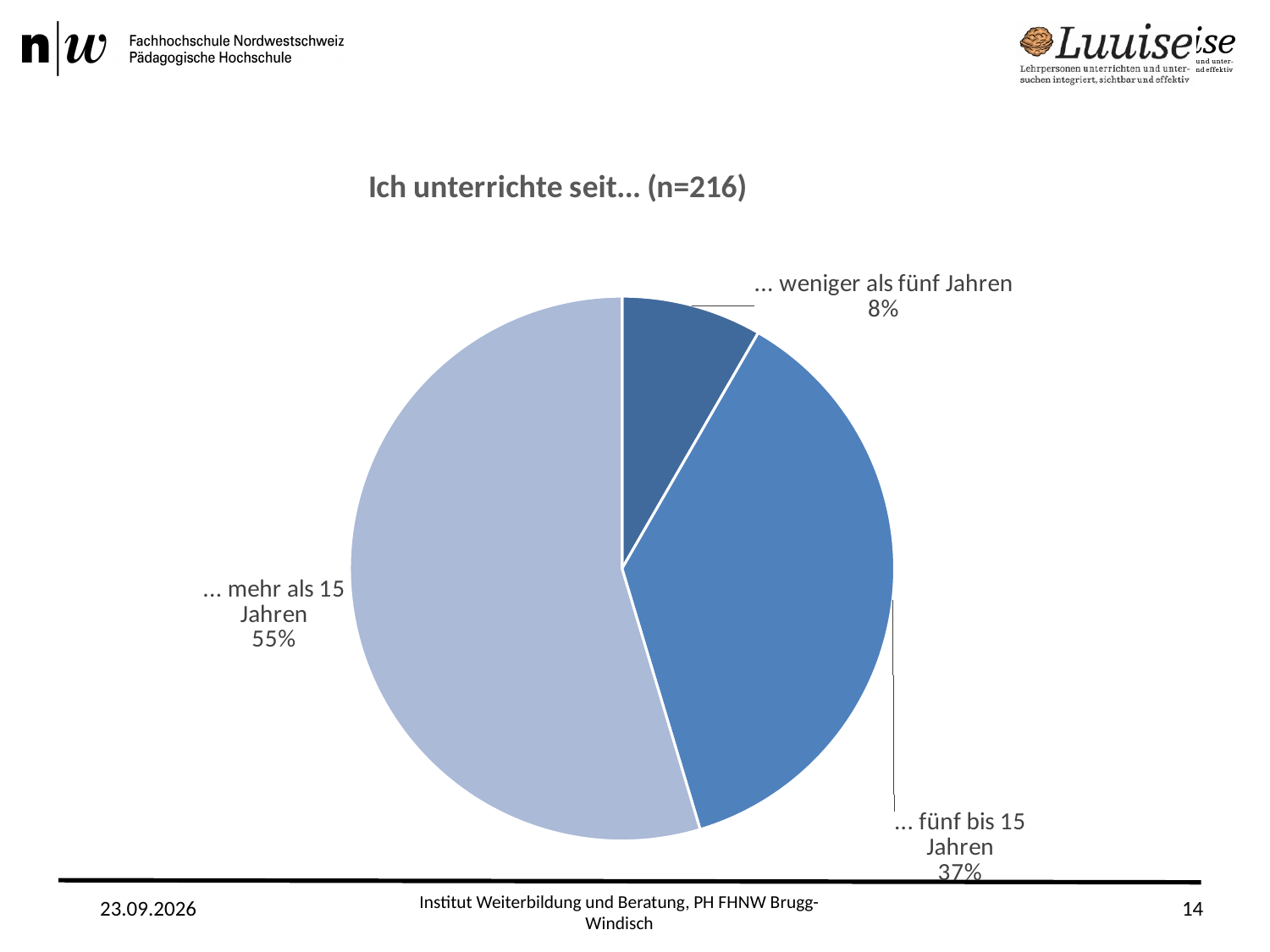
How many categories (slices) does the pie chart show? 3 Which category has the smallest slice of the pie? ... weniger als fünf Jahren Which slice is larger: "... fünf bis 15 Jahren" or "... weniger als fünf Jahren"? ... fünf bis 15 Jahren Which category has the largest slice of the pie? ... mehr als 15 Jahren How many respondents (n) does the chart title state? 216 What is the title of the chart? Ich unterrichte seit... (n=216) What is the difference in percentage points between the "... mehr als 15 Jahren" slice and the "... fünf bis 15 Jahren" slice? 18 percentage points What share of the pie is labelled "... weniger als fünf Jahren"? 8% What share of the pie is labelled "... fünf bis 15 Jahren"? 37% What is the difference in percentage points between the "... fünf bis 15 Jahren" slice and the "... weniger als fünf Jahren" slice? 29 percentage points What share of the pie is labelled "... mehr als 15 Jahren"? 55% What kind of chart is shown on the slide? Pie chart